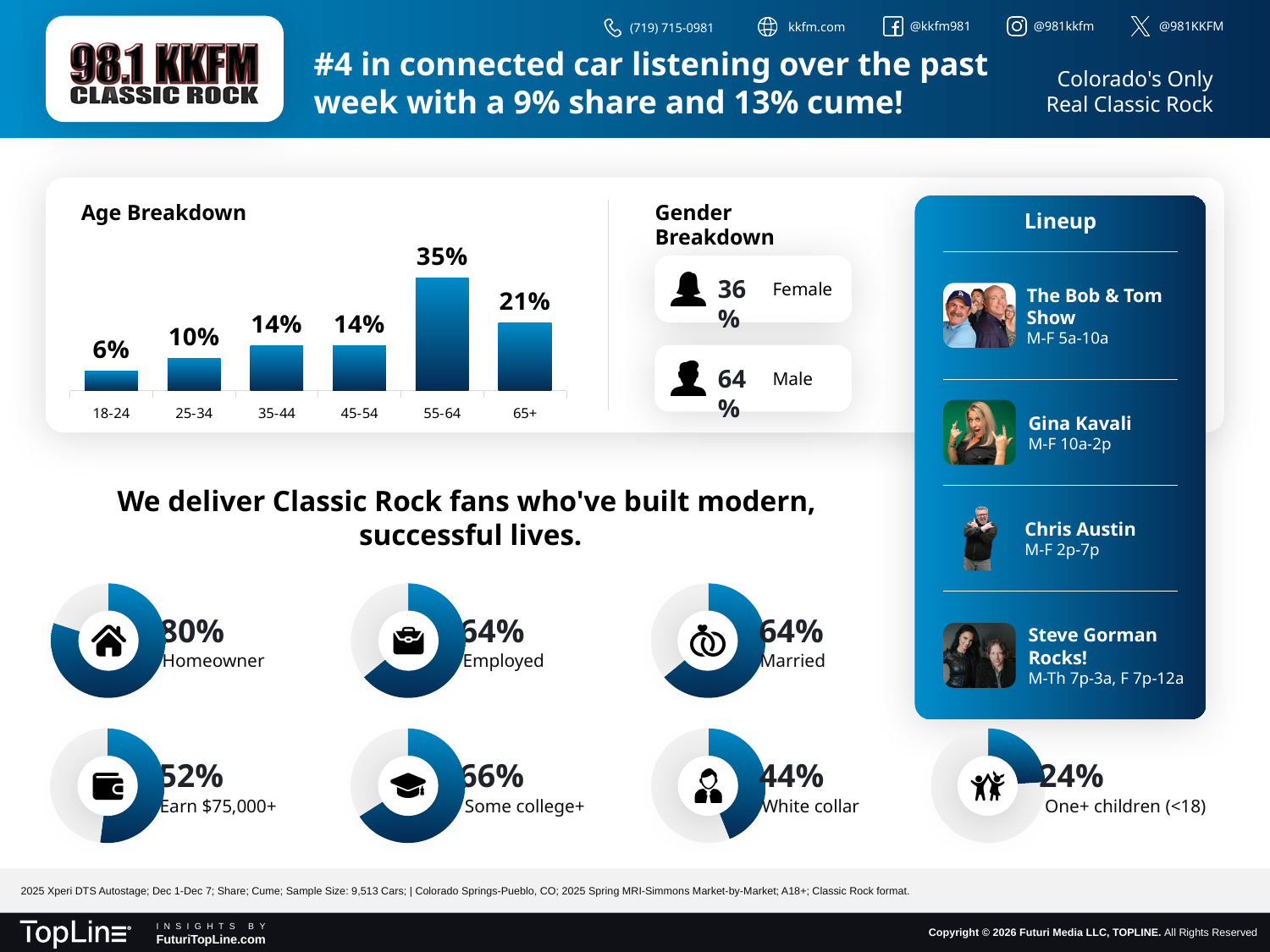
In the Age Breakdown chart, which age group has the lowest value? 18-24 In the Age Breakdown chart, what is the value for the 55-64 age group? 35% In the Age Breakdown chart, what is the difference between the values for 55-64 and 65+? 14% What kind of chart is the Age Breakdown chart? Bar chart In the Gender Breakdown, what percentage is Male? 64% In the Age Breakdown chart, what is the value for the 18-24 age group? 6% In the donut chart labeled One+ children (<18), what percentage is shown? 24% In the Age Breakdown chart, which is larger, the value for 25-34 or the value for 65+? 65+ In the Gender Breakdown, what is the difference between the Male and Female percentages? 28% In the donut chart labeled Homeowner, what percentage is shown? 80% In the Age Breakdown chart, which age group has the highest value? 55-64 How many age groups are shown in the Age Breakdown chart? 6